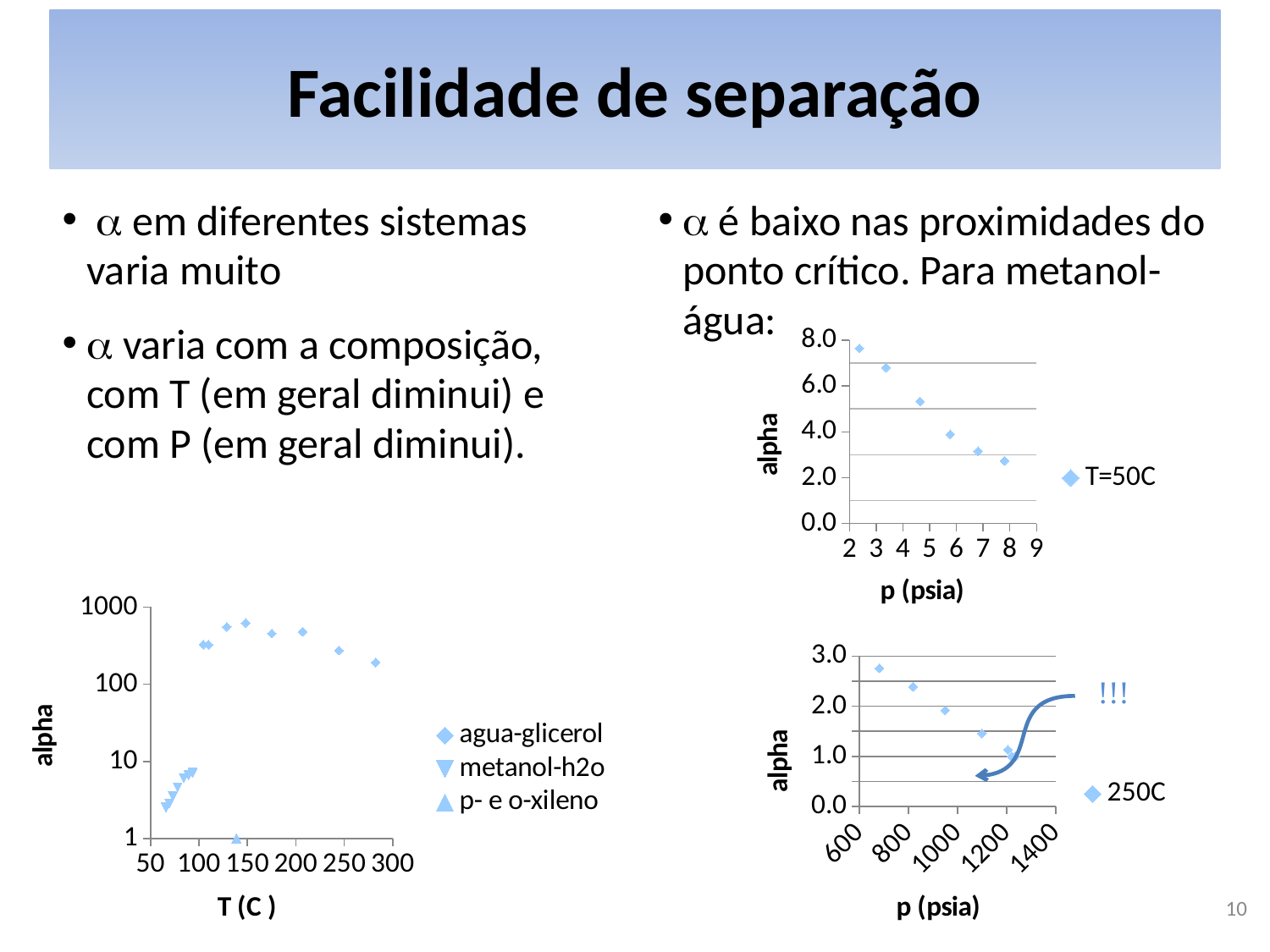
What is the legend entry of the top-right chart (alpha vs p (psia), 0 to 8.0 scale)? T=50C How many data points are plotted in the top-right chart (T=50C)? 6 In the bottom-left chart (alpha vs T (C )), which series has the highest alpha values: agua-glicerol or metanol-h2o? agua-glicerol In the top-right chart (T=50C), does alpha rise or fall as p (psia) increases? fall What kind of chart is the bottom-left chart with x axis 'T (C )'? scatter chart In the bottom-right chart (250C), is the alpha value at the lowest pressure greater or less than 2.0? greater How many series does the legend of the bottom-left chart (alpha vs T (C )) list? 3 In the bottom-left chart (alpha vs T (C )), are the alpha values for agua-glicerol greater or less than 100? greater In the bottom-right chart (250C), does alpha rise or fall as p (psia) increases? fall In the top-right chart (T=50C), is the alpha value at the lowest pressure greater or less than 6.0? greater What are the legend entries of the bottom-left chart (alpha vs T (C ))? agua-glicerol, metanol-h2o, p- e o-xileno